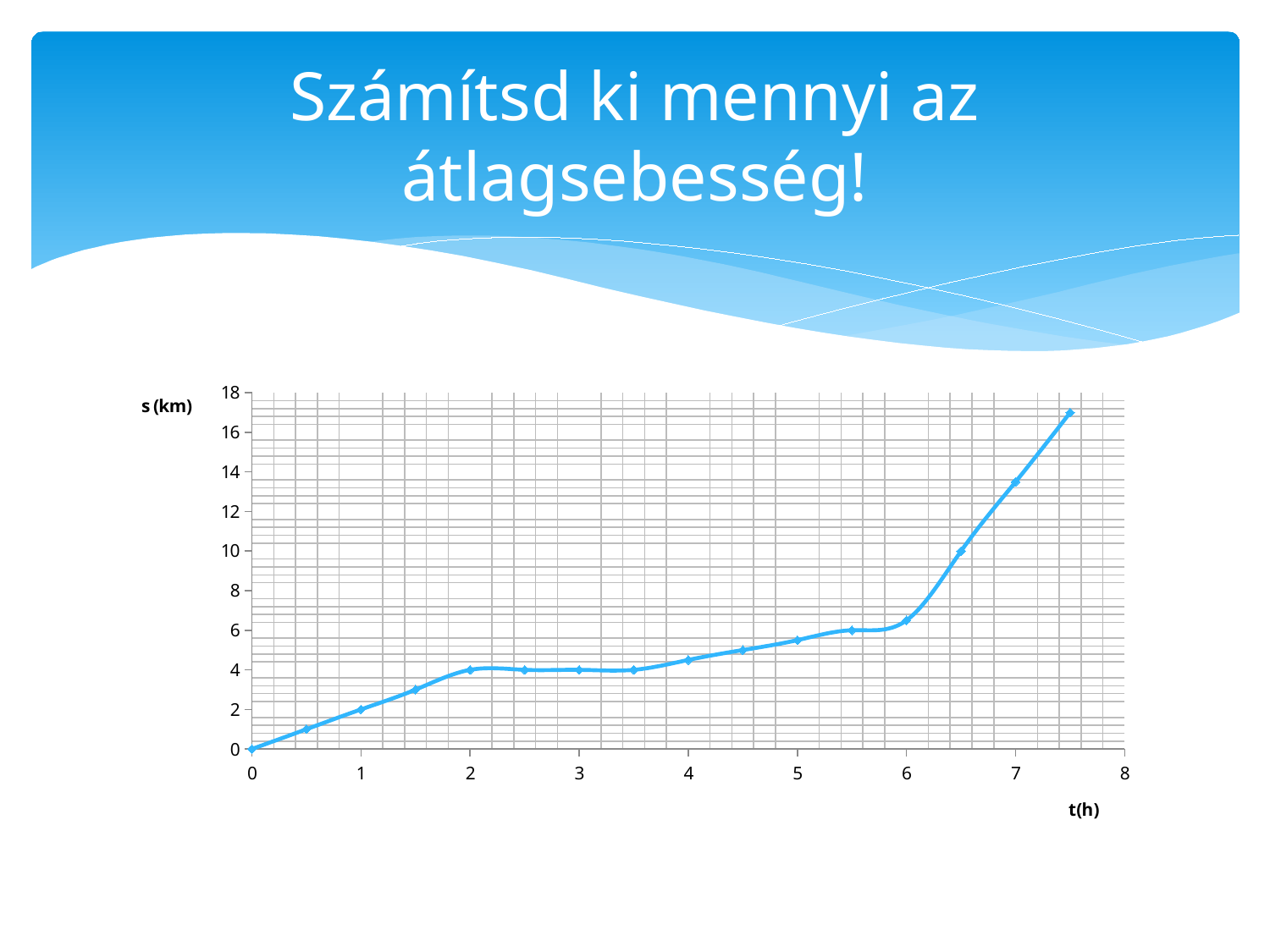
Which has a larger s value: t = 3 h or t = 6.5 h? t = 6.5 h Is the value of s at t = 7.5 h greater or less than 16? greater Does s (km) generally rise or fall as t (h) increases? rise At which value of t (h) is s (km) highest? 7.5 What type of chart is shown on the slide? line chart What is the difference in s (km) between t = 6.5 h and t = 2 h? 6 What is the value of s (km) at t = 6.5 h? 10 At which value of t (h) is s (km) lowest? 0 What is the value of s (km) at t = 2 h? 4 Is the value of s at t = 0.5 h greater or less than 2? less What is the value of s (km) at t = 1 h? 2